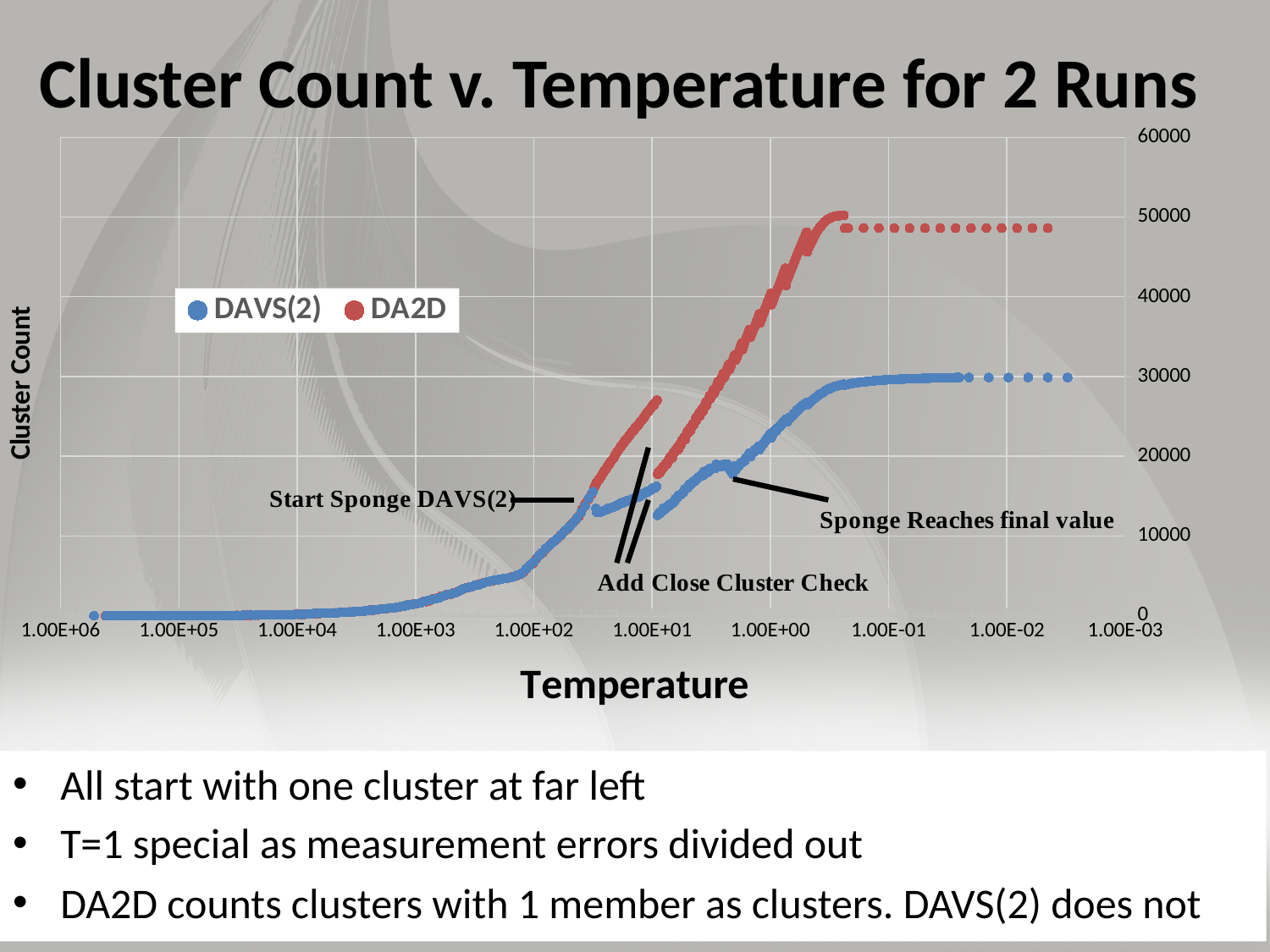
How many series does the legend list? 2 Which series reaches the higher final cluster count at the right end of the chart, DAVS(2) or DA2D? DA2D Moving from left to right along the x axis, does the DAVS(2) cluster count generally rise or fall? rise Is the final cluster count for DA2D at the right end of the chart greater or less than 40000? greater What is the title of the chart? Cluster Count v. Temperature for 2 Runs Is the final cluster count for DAVS(2) at the right end of the chart greater or less than 40000? less Which series has the higher cluster count at a temperature of 1.00E+00, DAVS(2) or DA2D? DA2D What are the two series named in the legend? DAVS(2) and DA2D Is the highest cluster count reached by DA2D greater or less than 60000? less What kind of chart is shown on the slide? scatter chart